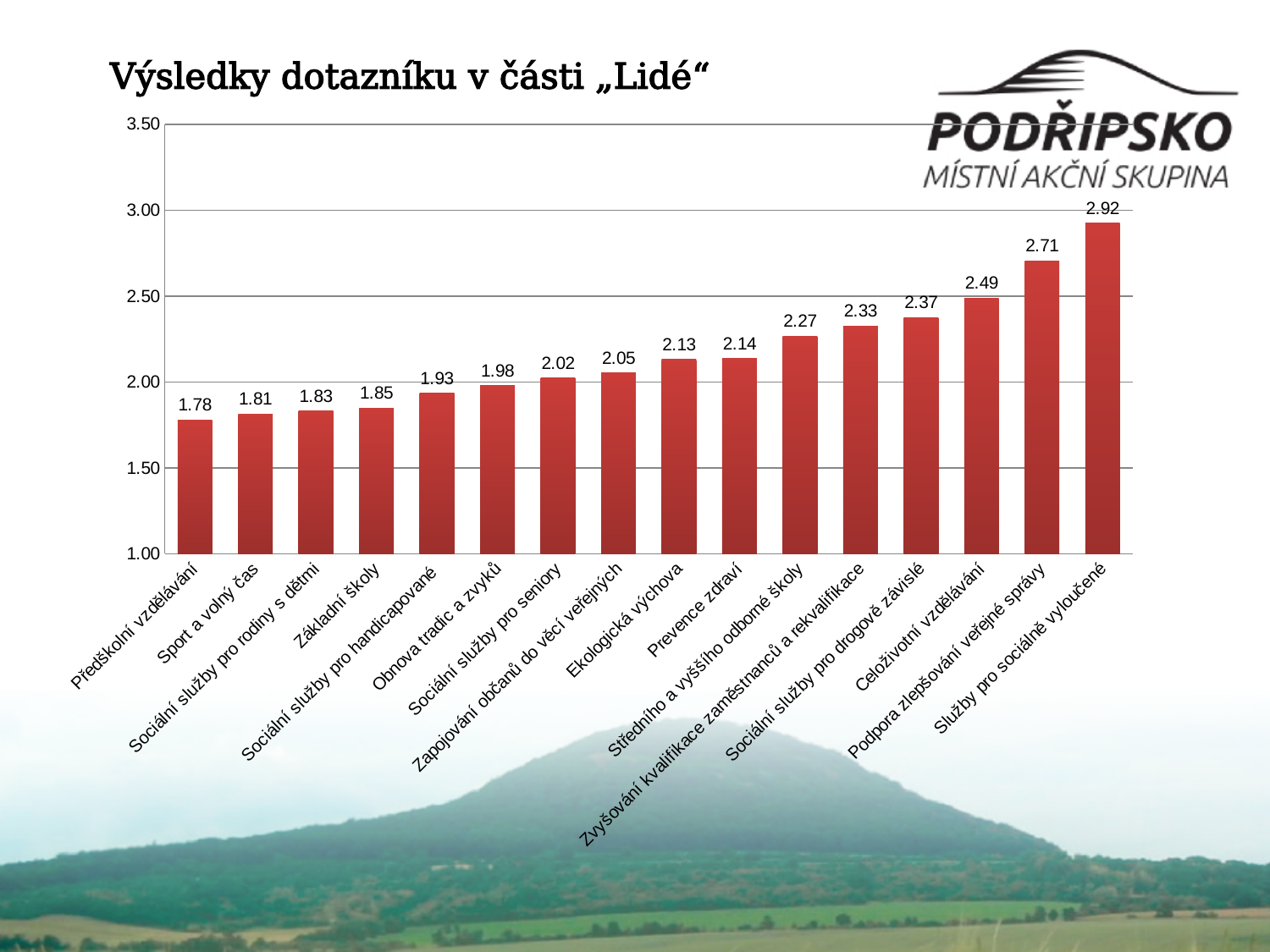
Which category has the highest value? Služby pro sociálně vyloučené Which is larger, the value for Sociální služby pro seniory or the value for Obnova tradic a zvyků? Sociální služby pro seniory Which category has the lowest value? Předškolní vzdělávání What is the value for Základní školy? 1.85 What is the difference between the values for Služby pro sociálně vyloučené and Podpora zlepšování veřejné správy? 0.21 Do the values rise or fall from left to right along the x axis? rise What kind of chart is shown on the slide? bar chart How many categories are shown in the chart? 16 What is the value for Ekologická výchova? 2.13 What is the title of the slide containing the chart? Výsledky dotazníku v části „Lidé“ What is the value for Celoživotní vzdělávání? 2.49 Is the value for Sociální služby pro drogově závislé greater or less than 2.50? less